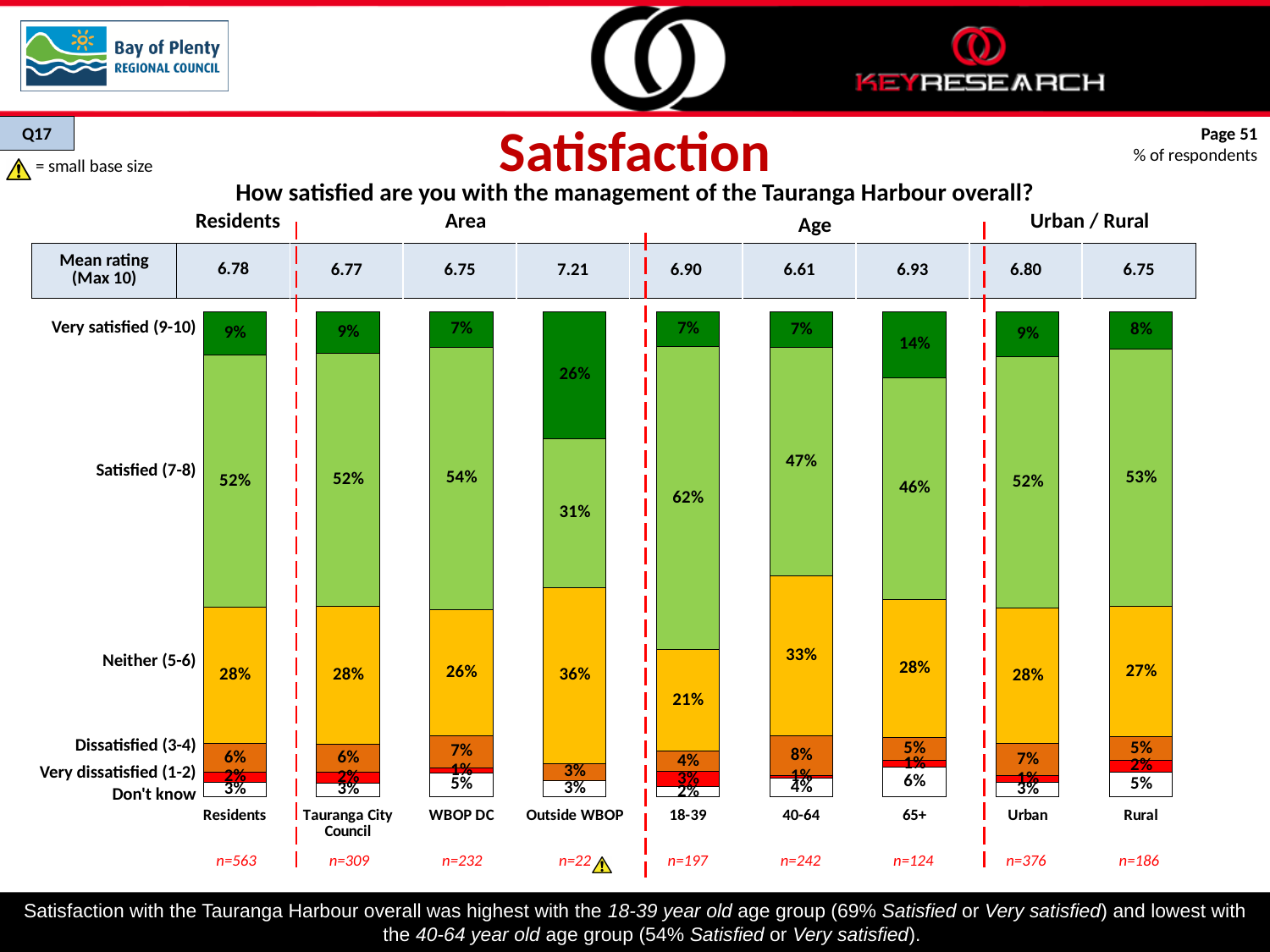
What percentage of Outside WBOP respondents are Very satisfied (9-10)? 26% What is the combined Satisfied (7-8) and Very satisfied (9-10) percentage for the 65+ age group? 60% Which group has the highest Very satisfied (9-10) percentage? Outside WBOP What is the mean rating (Max 10) for Outside WBOP? 7.21 Which age group has the lowest mean rating? 40-64 What is the sample size (n) for the Rural group? n=186 What is the Neither (5-6) percentage for the 40-64 age group? 33% What percentage of 18-39 year olds are Satisfied (7-8) with the management of the Tauranga Harbour overall? 62% Which has a higher Neither (5-6) percentage, Urban or Rural? Urban What type of chart is used on this slide? Stacked bar chart What is the difference between the Satisfied (7-8) percentages for 18-39 and 40-64? 15% How many respondent groups (bars) are shown in the chart? 9